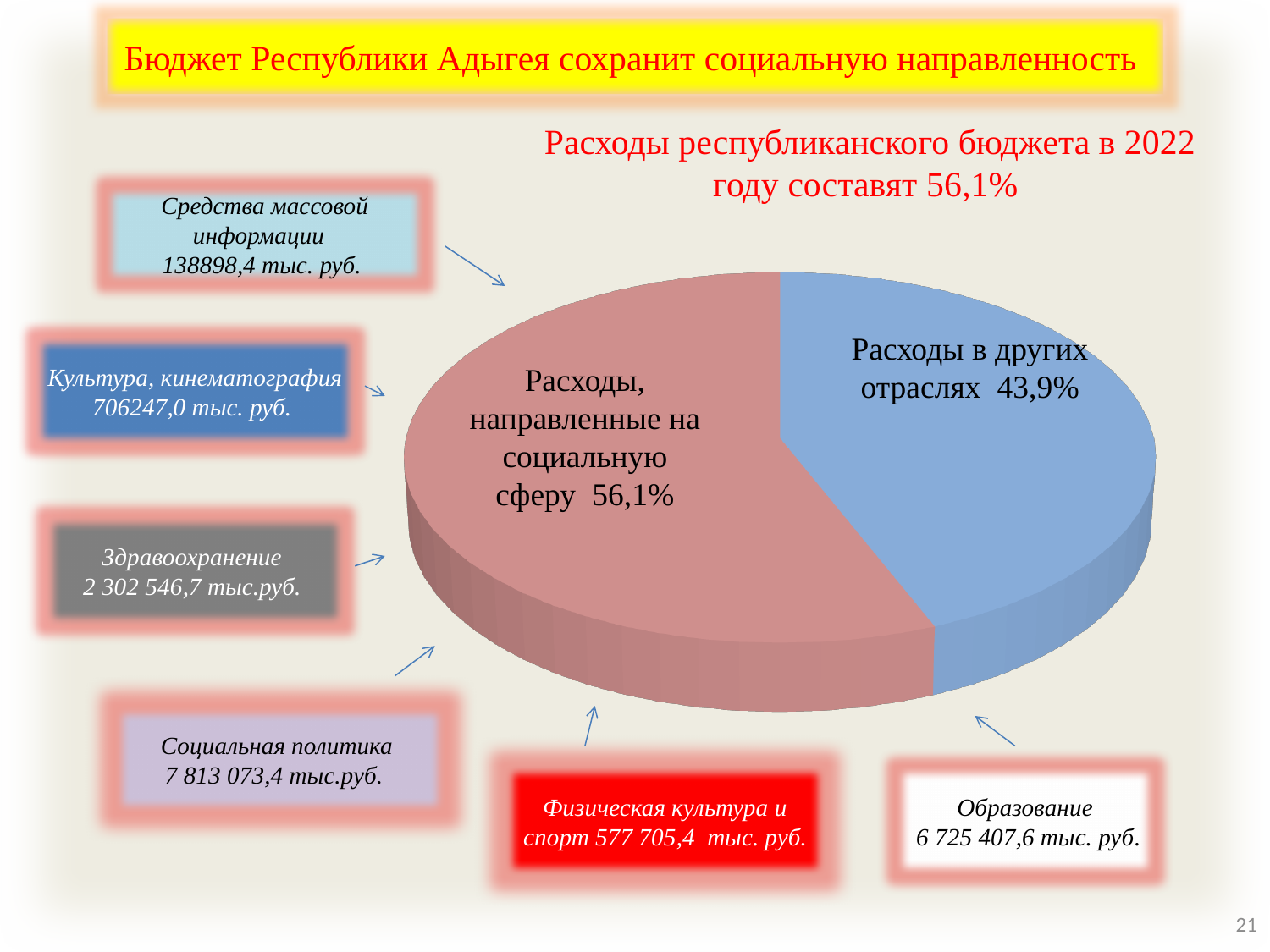
Which slice of the pie chart is the largest? Расходы, направленные на социальную сферу By how many percentage points does the social sphere slice exceed the other sectors slice? 12,2% What kind of chart is shown on the slide? pie chart What colour is the slice for "Расходы в других отраслях"? blue What do the two slices of the pie chart add up to? 100% What colour is the slice for "Расходы, направленные на социальную сферу"? pink What share of the pie is labelled "Расходы в других отраслях"? 43,9% What share of the pie is labelled "Расходы, направленные на социальную сферу"? 56,1% Which slice of the pie chart is the smallest? Расходы в других отраслях How many slices does the pie chart have? 2 Which is larger: the share for "Расходы в других отраслях" or the share for "Расходы, направленные на социальную сферу"? Расходы, направленные на социальную сферу